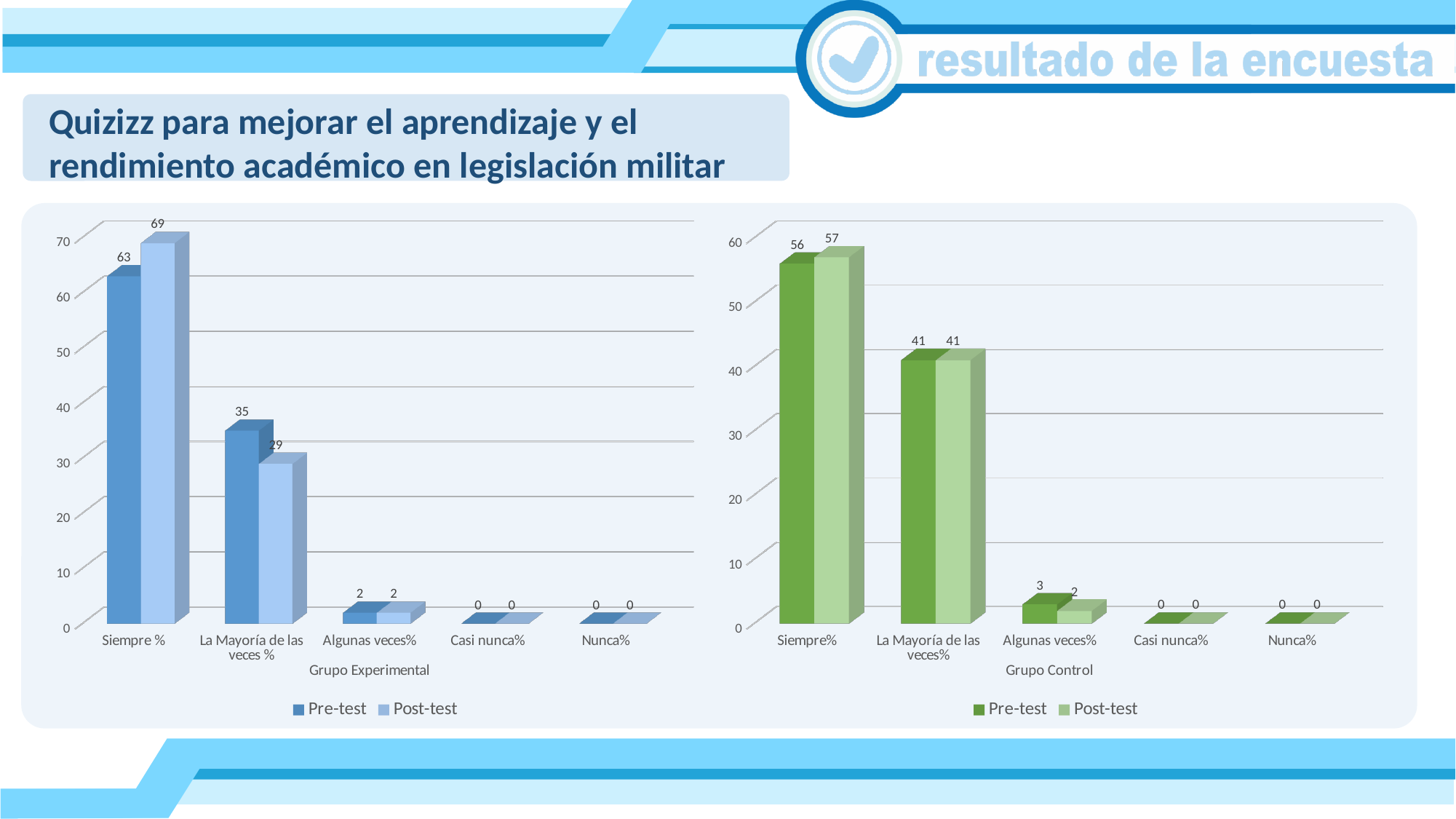
In the Grupo Experimental chart, is the Pre-test value for La Mayoría de las veces % larger or smaller than the Post-test value? larger In the Grupo Experimental chart, which category has the highest Pre-test value? Siempre % How many categories are shown on the x axis of the Grupo Control chart? 5 In the Grupo Experimental chart, what is the Pre-test value for La Mayoría de las veces %? 35 In the Grupo Control chart, what is the Pre-test value for Siempre%? 56 How many series does the legend of the Grupo Experimental chart list? 2 What kind of chart is the Grupo Control chart? bar chart In the Grupo Control chart, do the Pre-test values rise or fall from Siempre% to Nunca%? fall In the Grupo Experimental chart, what is the Post-test value for Siempre %? 69 In the Grupo Control chart, what is the Post-test value for Algunas veces%? 2 In the Grupo Control chart, what is the difference between the Pre-test values for Siempre% and La Mayoría de las veces%? 15 In the Grupo Experimental chart, what is the difference between the Post-test and Pre-test values for Siempre %? 6